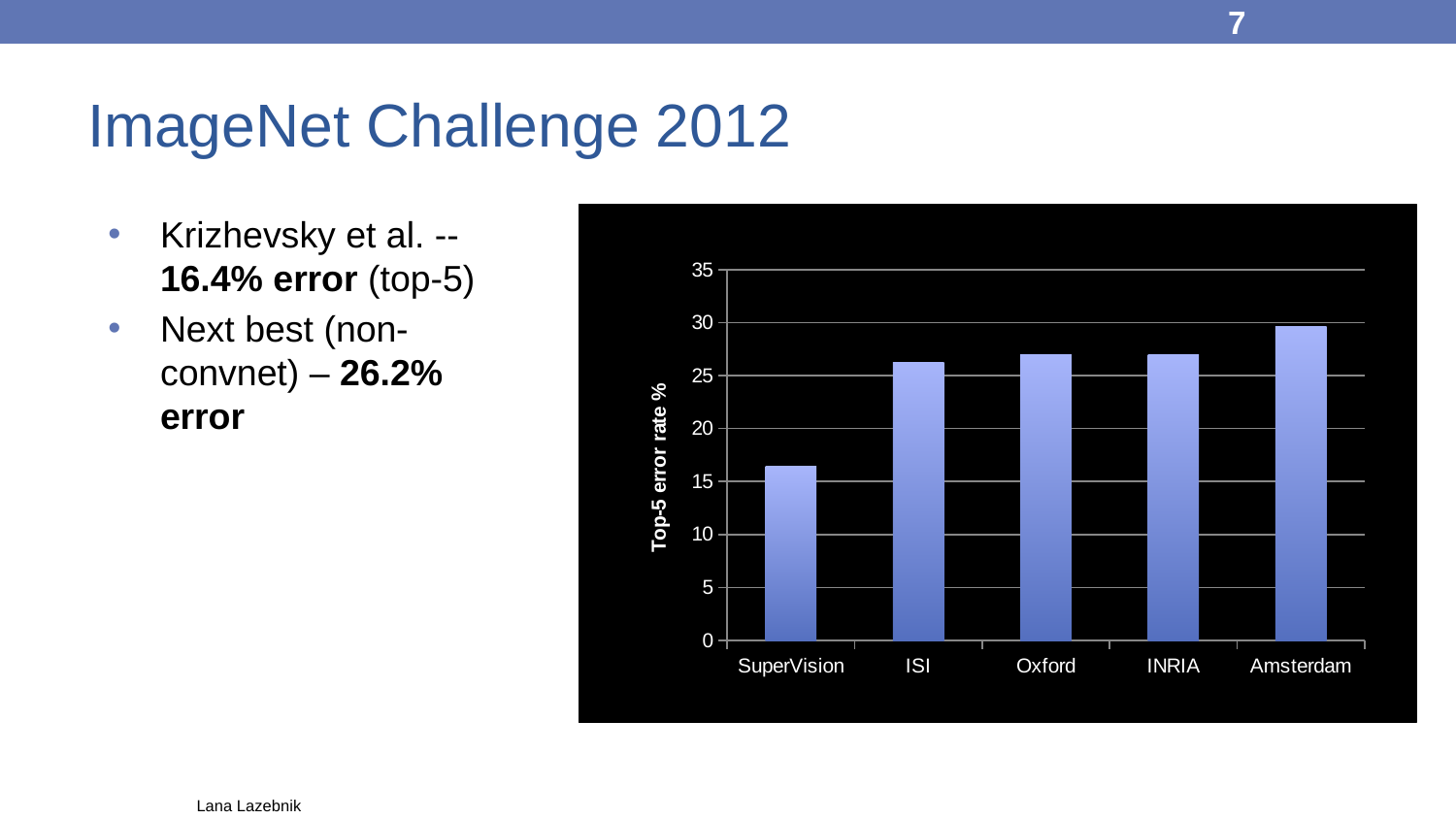
What kind of chart is shown on the slide? bar chart Which has a higher top-5 error rate, INRIA or Amsterdam? Amsterdam Is the value for ISI greater or less than 25? greater Is the value for SuperVision greater or less than 20? less Which has a higher top-5 error rate, SuperVision or ISI? ISI What is the label of the y axis of the chart? Top-5 error rate % Is the value for Amsterdam greater or less than 25? greater What is the highest tick value shown on the y axis? 35 How many categories are shown on the x axis of the chart? 5 Which category has the lowest top-5 error rate? SuperVision Which category has the highest top-5 error rate? Amsterdam